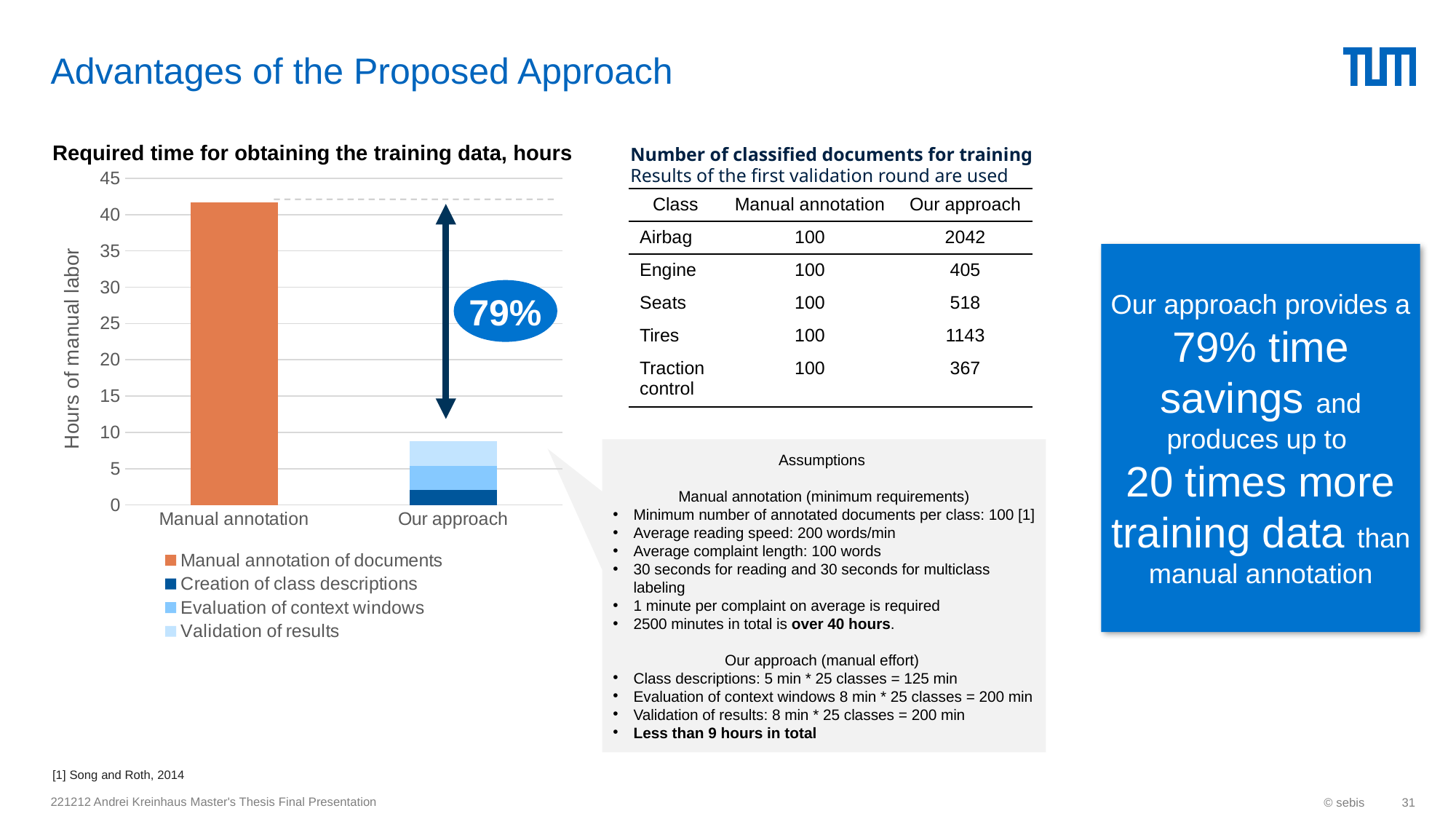
How many categories are shown on the x axis of the chart? 2 Is the total value for Our approach greater or less than 10? less Is the value for Manual annotation greater or less than 40? greater How many series does the chart's legend list? 4 What is the title of the chart on the slide? Required time for obtaining the training data, hours Which category has the tallest bar in the chart? Manual annotation What kind of chart is shown on the slide? Bar chart What is the label of the y axis of the chart? Hours of manual labor Which bar is taller, Manual annotation or Our approach? Manual annotation Which category has the shortest bar in the chart? Our approach What percentage is shown in the blue oval next to the arrow between the two bars? 79% Is the value for Manual annotation greater or less than 45? less